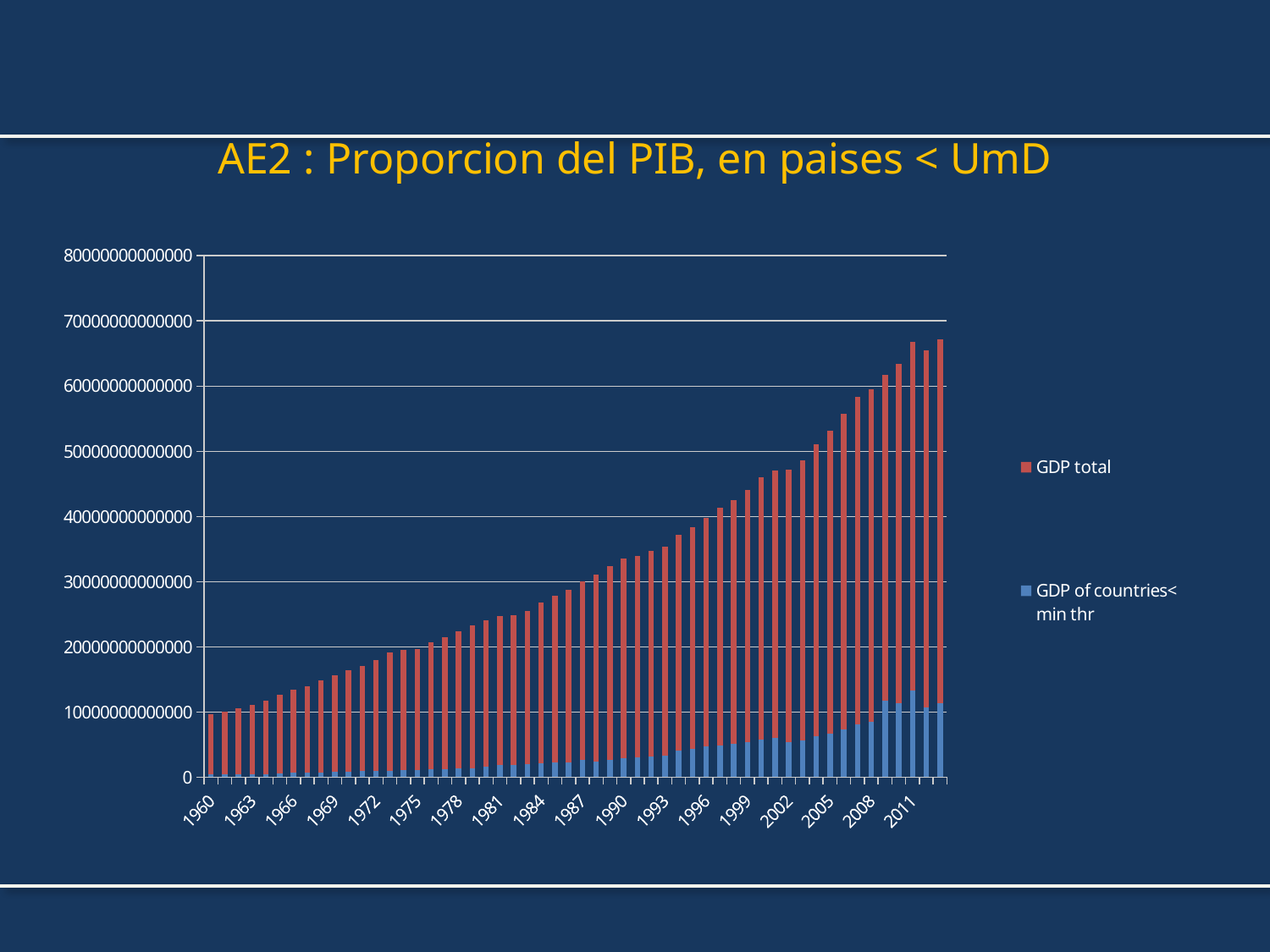
Is the value of GDP total for 2011 greater or less than 60000000000000? less Which is larger in 2011, GDP total or GDP of countries< min thr? GDP total How many series does the legend list? 2 Does GDP total rise or fall from 1960 to 2011? rise What is the title of the chart? AE2 : Proporcion del PIB, en paises < UmD Which year has the larger GDP total, 1960 or 2011? 2011 Is the value of GDP total for 2005 greater or less than 50000000000000? less Is the value of GDP of countries< min thr for 2011 greater or less than 10000000000000? greater Which series is drawn in blue? GDP of countries< min thr What kind of chart is shown on the slide? bar chart